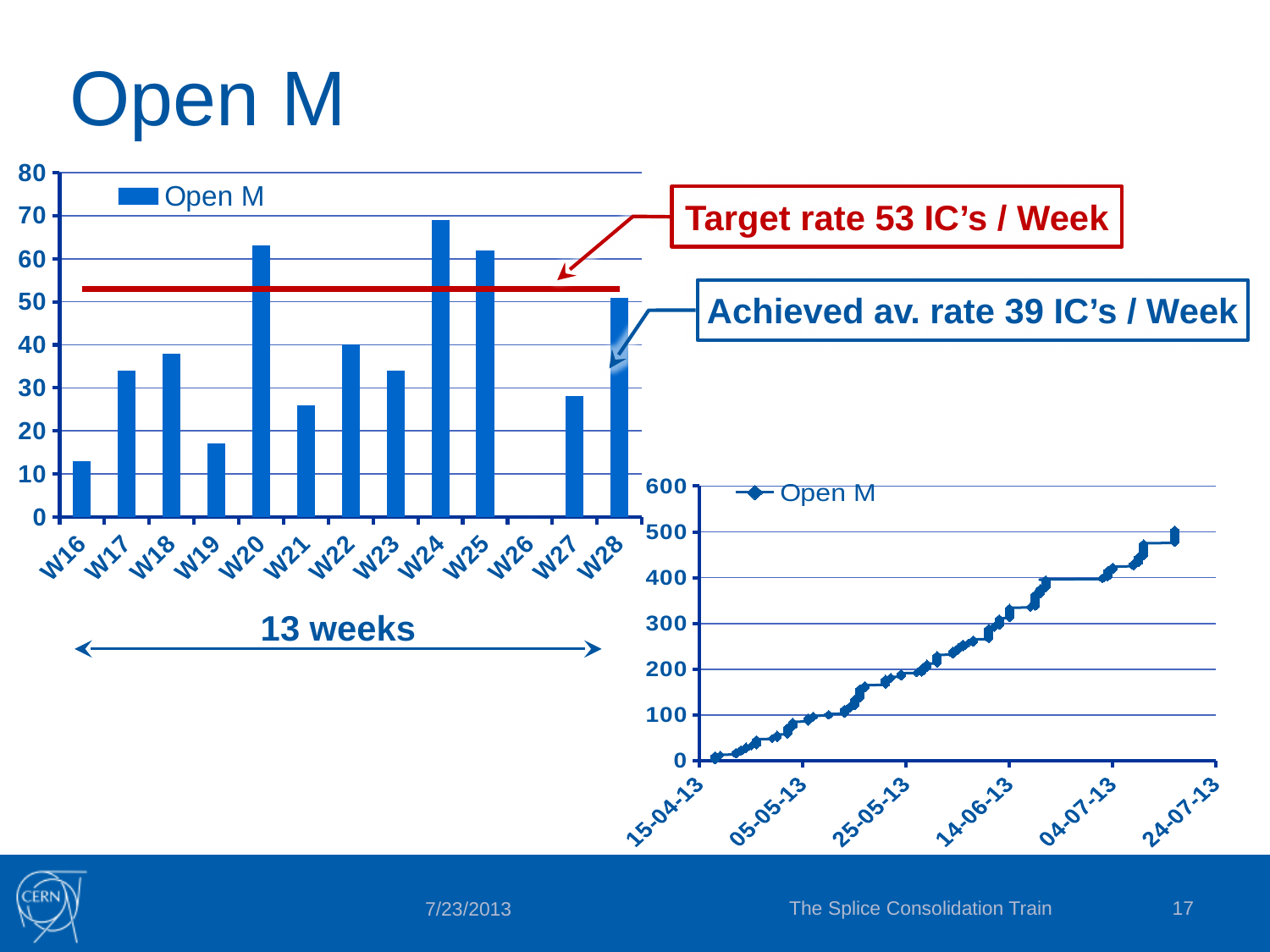
In the bar chart on the left, which has the larger value, W20 or W21? W20 What target rate does the red line in the bar chart represent, according to the slide? 53 IC's / Week What kind of chart is the chart on the lower right of the slide? line chart In the bar chart on the left, how many weeks are shown on the x axis? 13 What kind of chart is the chart on the left of the slide? bar chart In the line chart on the lower right, do the values rise or fall from left to right along the x axis? rise In the line chart on the lower right, is the highest plotted value greater or less than 400? greater In the bar chart on the left, which week has the highest bar? W24 In the bar chart on the left, is the value for W16 greater or less than 20? less In the bar chart on the left, is the value for W21 greater or less than 30? less In the bar chart on the left, how many series does the legend list? 1